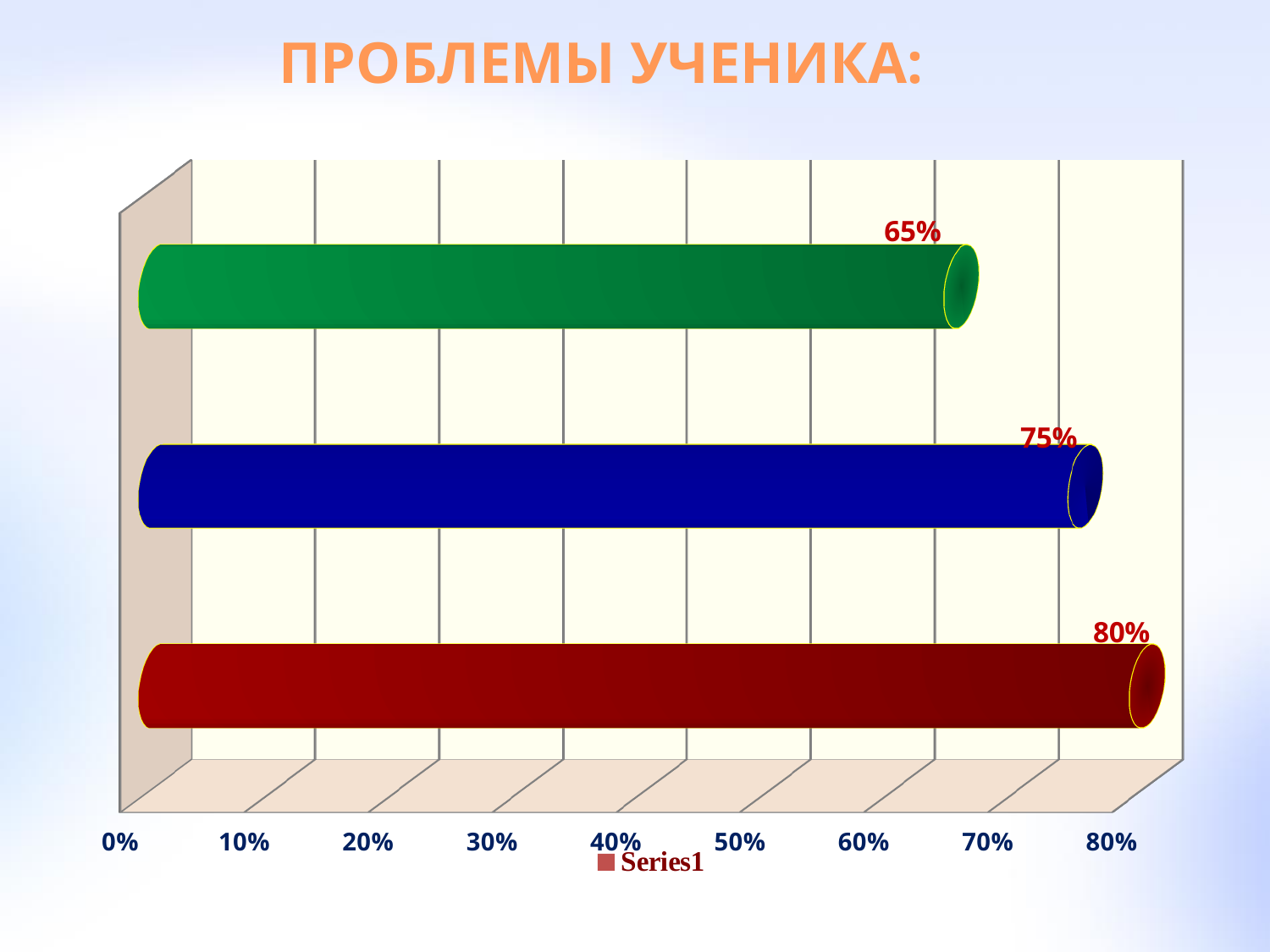
What kind of chart is shown on the slide? Bar chart What value is shown on the green (top) bar? 65% Which is larger, the value of the blue bar or the value of the green bar? The blue bar What value is shown on the blue (middle) bar? 75% What value is shown on the red (bottom) bar? 80% How many bars are plotted in the chart? 3 Which bar has the lowest value? The green (top) bar, 65% What is the difference between the blue bar's value and the green bar's value? 10% What series name does the legend show? Series1 Is the value of the green bar greater or less than 70%? less What is the difference between the red bar's value and the green bar's value? 15% Which bar has the highest value? The red (bottom) bar, 80%